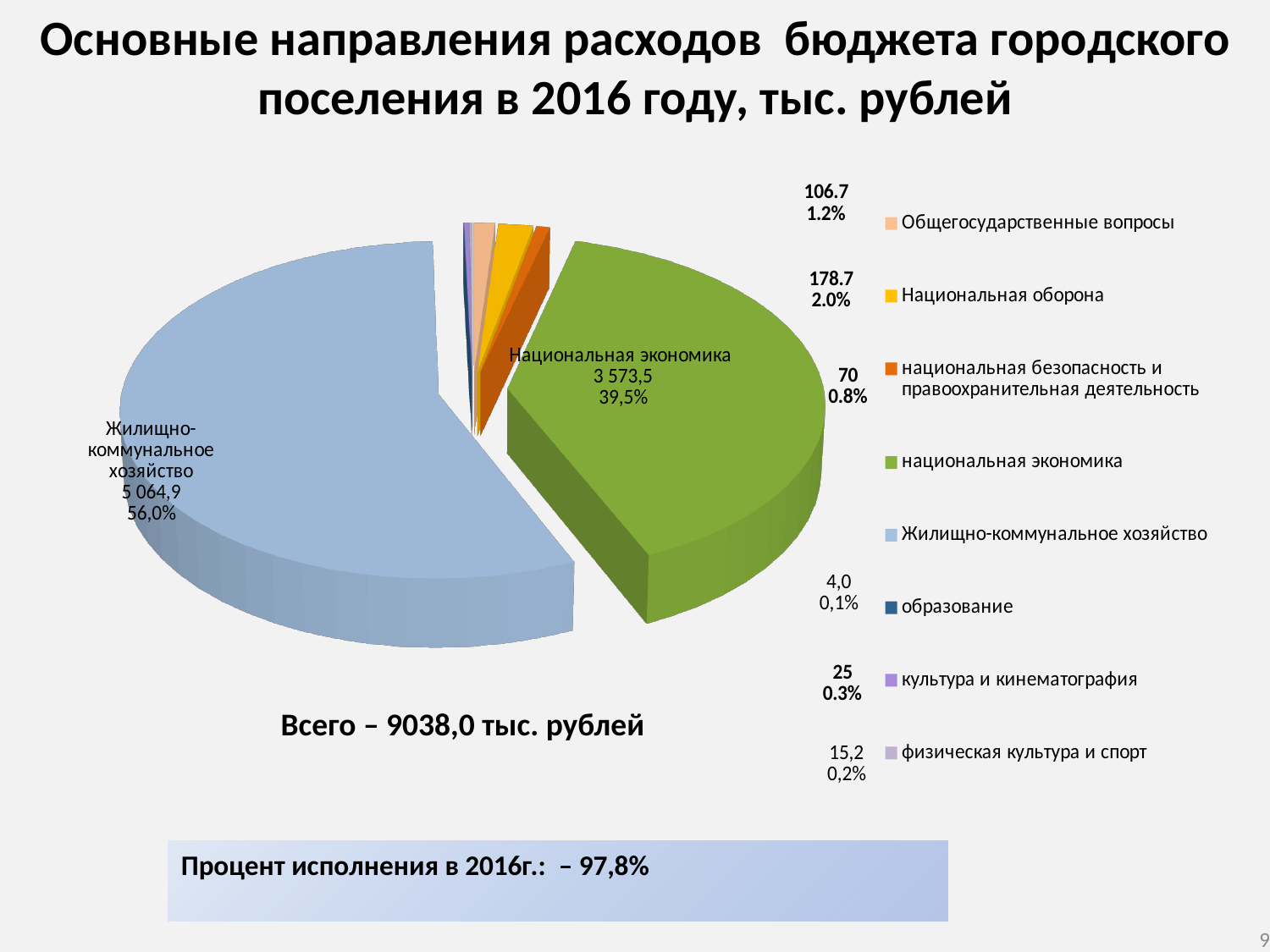
What share of the pie does Жилищно-коммунальное хозяйство take? 56,0% How many categories does the legend of the pie chart list? 8 What kind of chart is shown on the slide? Pie chart Which category has the largest slice of the pie? Жилищно-коммунальное хозяйство What is the value shown for Жилищно-коммунальное хозяйство? 5 064,9 What is the difference between the values for Жилищно-коммунальное хозяйство and Национальная экономика? 1 491,4 Which is larger, Жилищно-коммунальное хозяйство or Национальная экономика? Жилищно-коммунальное хозяйство What total amount is stated below the pie chart? 9038,0 тыс. рублей What share is shown next to the legend entry Национальная оборона? 2.0% What is the value shown for Национальная экономика? 3 573,5 What percent of execution for 2016 is stated on the slide? 97,8% What share of the pie does Национальная экономика take? 39,5%